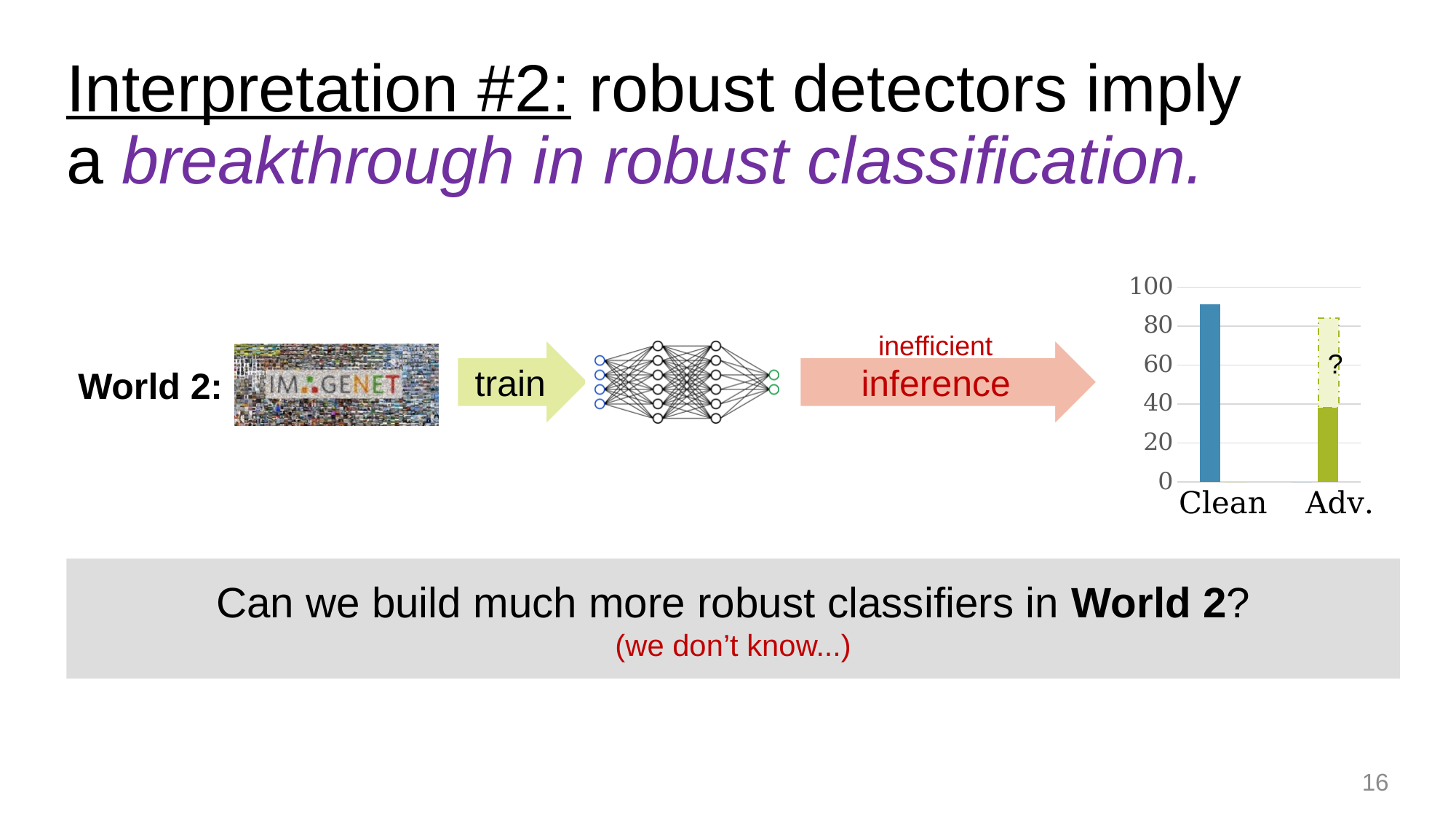
What symbol is printed inside the dashed bar above Adv.? ? How many categories are shown on the x axis of the bar chart? 2 What is the highest tick value shown on the y axis of the chart? 100 Is the solid bar for Clean taller or shorter than the solid bar for Adv.? taller Which category has the tallest solid bar in the chart? Clean Is the value of the solid bar for Adv. greater or less than 20? greater Is the value of the solid bar for Adv. greater or less than 60? less Which category has the shortest solid bar in the chart? Adv. What kind of chart is shown on the right of the slide? bar chart Is the value for Clean greater or less than 80? greater